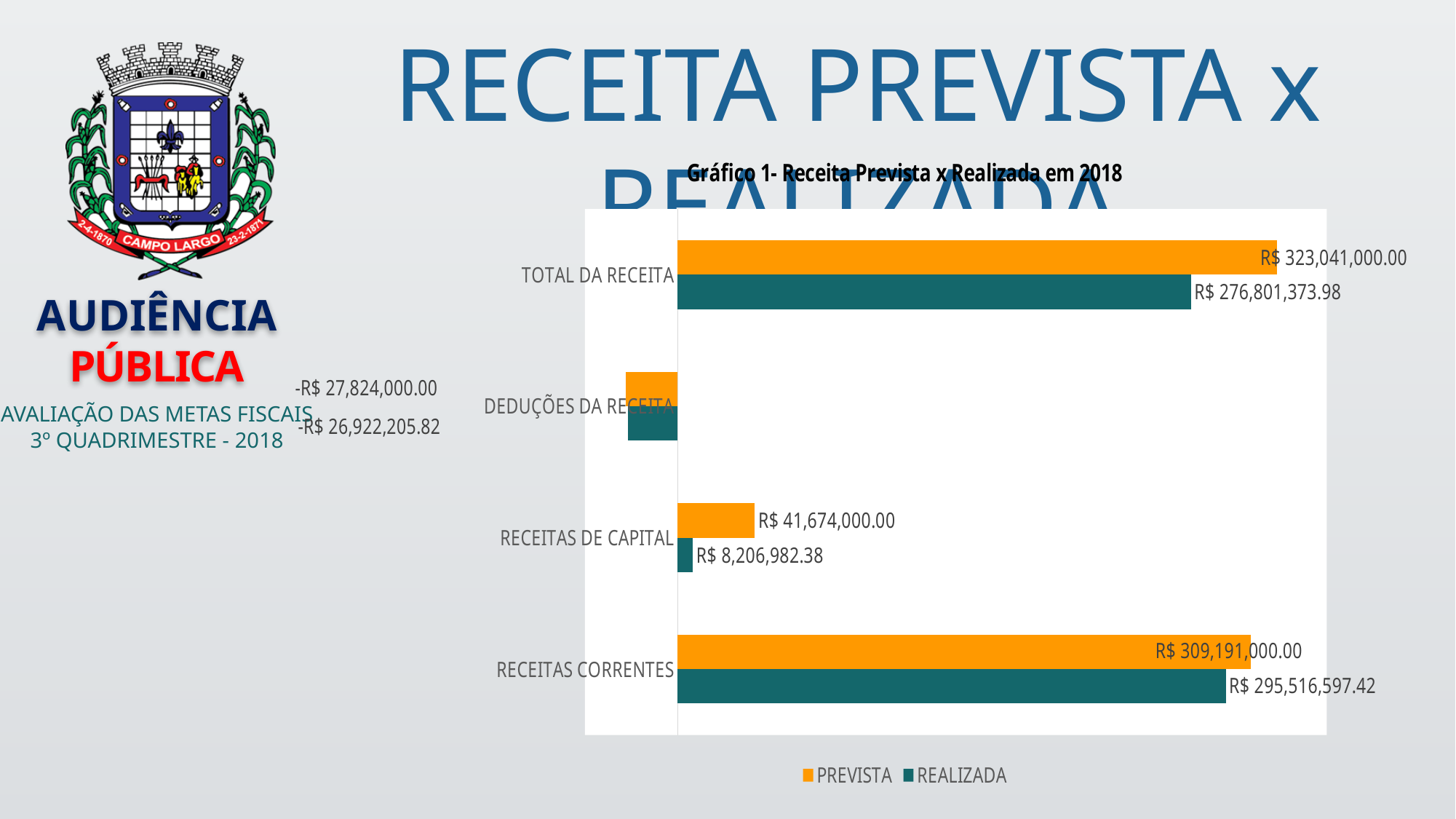
What is the difference between the PREVISTA and REALIZADA values for RECEITAS DE CAPITAL? R$ 33,467,017.62 Which category has the lowest REALIZADA value? DEDUÇÕES DA RECEITA Which category has the highest PREVISTA value? TOTAL DA RECEITA What is the REALIZADA value for TOTAL DA RECEITA? R$ 276,801,373.98 How many categories are shown on the chart? 4 What is the PREVISTA value for DEDUÇÕES DA RECEITA? -R$ 27,824,000.00 What type of chart is shown on the slide? Bar chart What is the REALIZADA value for RECEITAS DE CAPITAL? R$ 8,206,982.38 What is the REALIZADA value for RECEITAS CORRENTES? R$ 295,516,597.42 What is the PREVISTA value for TOTAL DA RECEITA? R$ 323,041,000.00 For RECEITAS CORRENTES, which is larger: the PREVISTA value or the REALIZADA value? PREVISTA How many series does the legend list? 2